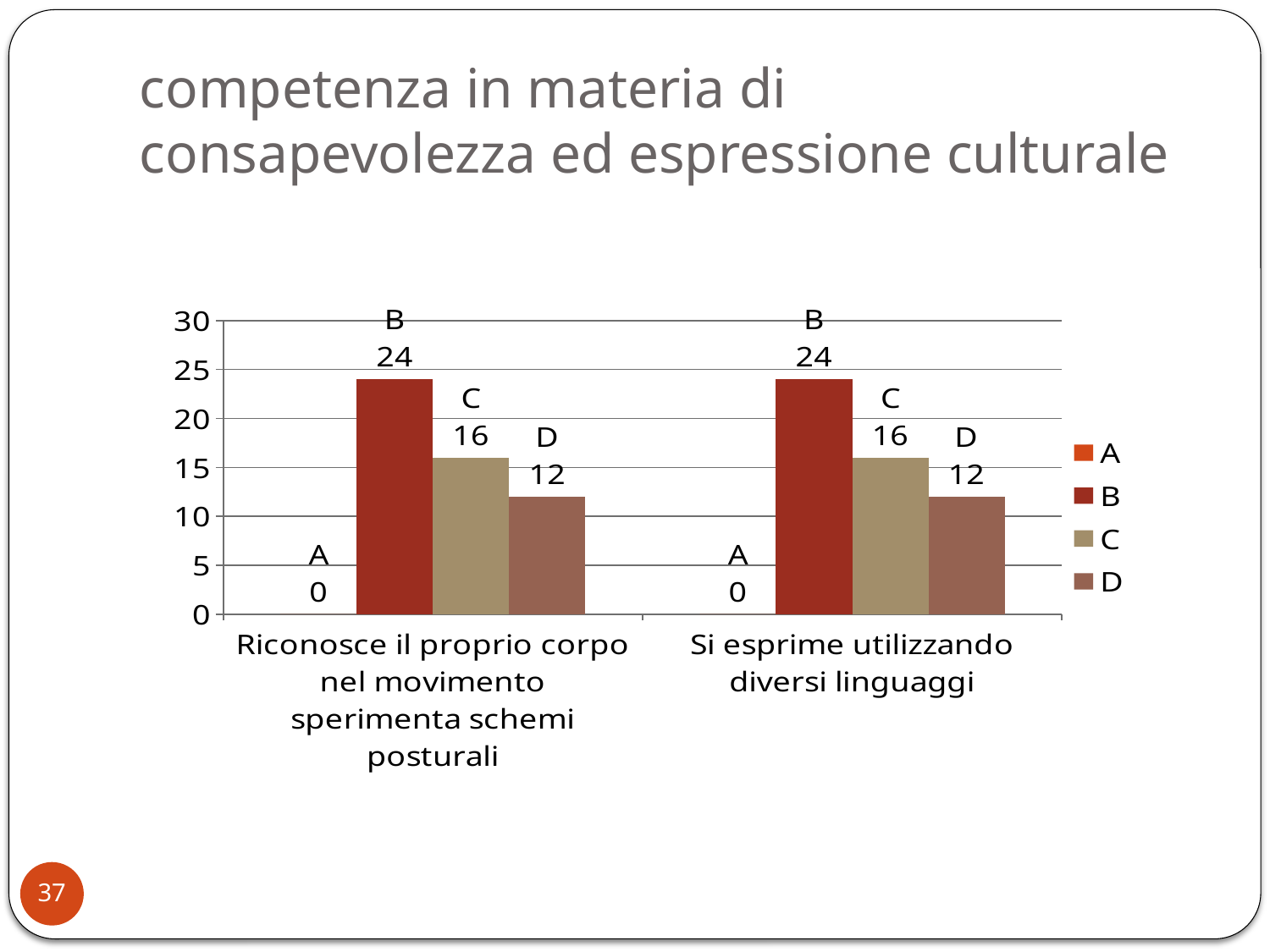
What is the value of series D for the category "Si esprime utilizzando diversi linguaggi"? 12 For the category "Riconosce il proprio corpo nel movimento sperimenta schemi posturali", which is larger: series C or series D? C What kind of chart is shown on the slide? Bar chart How many categories are shown on the x axis of the chart? 2 What is the difference between the values of series B and series D for the category "Si esprime utilizzando diversi linguaggi"? 12 Which series has the highest value for the category "Riconosce il proprio corpo nel movimento sperimenta schemi posturali"? B What is the value of series C for the category "Riconosce il proprio corpo nel movimento sperimenta schemi posturali"? 16 What is the value of series B for the category "Si esprime utilizzando diversi linguaggi"? 24 What is the total of the values for series A, B, C and D in the category "Si esprime utilizzando diversi linguaggi"? 52 Which series has the lowest value for the category "Si esprime utilizzando diversi linguaggi"? A What is the value of series A for the category "Riconosce il proprio corpo nel movimento sperimenta schemi posturali"? 0 How many series does the legend list? 4